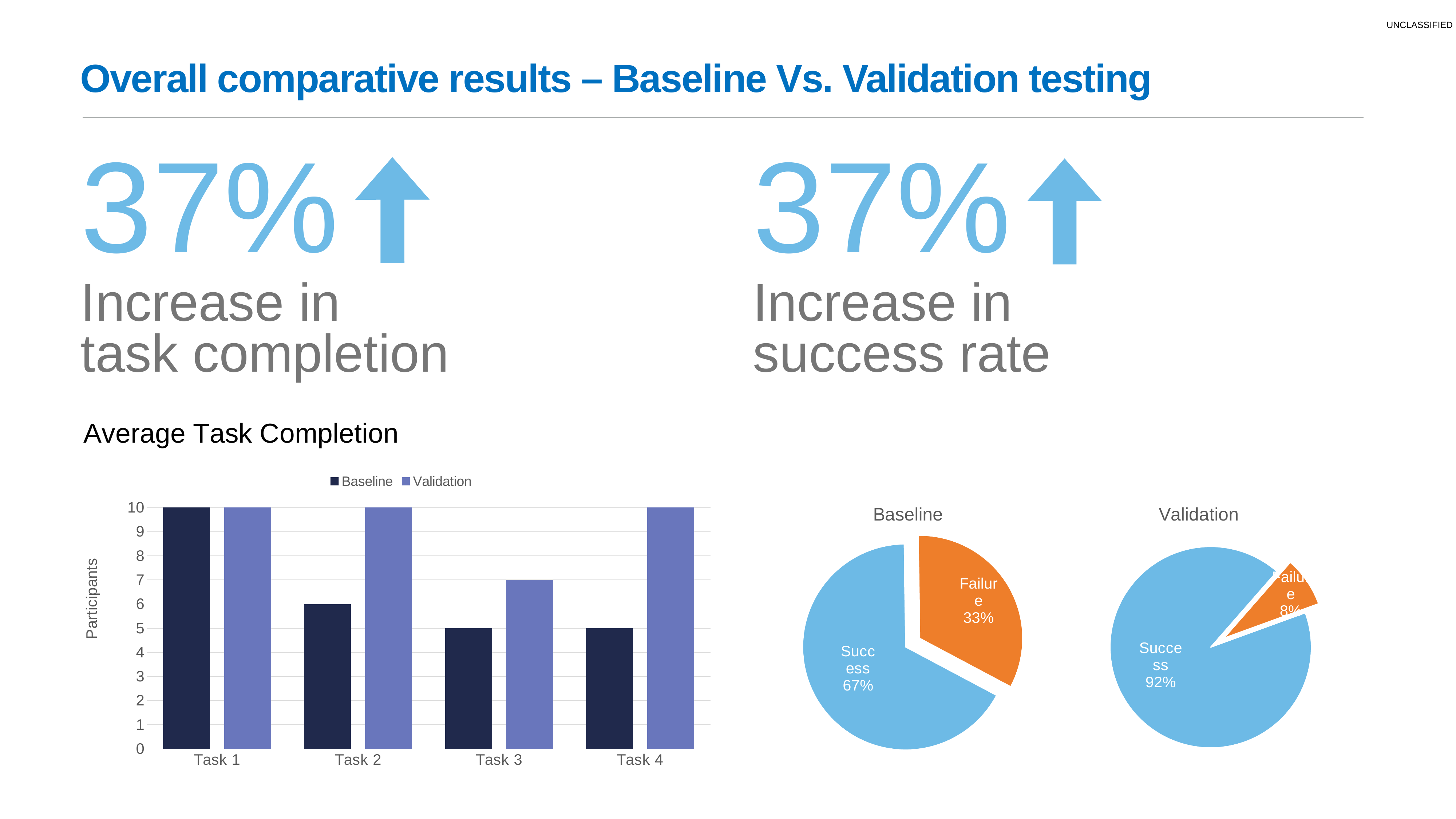
In the Average Task Completion chart, what is the Baseline value for Task 4? 5 In the Average Task Completion chart, which task has the lowest Validation value? Task 3 In the Average Task Completion chart, what is the Validation value for Task 3? 7 In the Average Task Completion chart, what is the Baseline value for Task 2? 6 In the Average Task Completion chart, which is larger for Task 3, the Baseline value or the Validation value? Validation What kind of chart is the Average Task Completion chart? Bar chart In the Baseline pie chart, what share is Failure? 33% In the Average Task Completion chart, which task has the highest Baseline value? Task 1 In the Average Task Completion chart, what is the difference between the Validation and Baseline values for Task 2? 4 How many series does the legend of the Average Task Completion chart list? 2 How many tasks are shown on the x axis of the Average Task Completion chart? 4 In the Validation pie chart, what share is Success? 92%